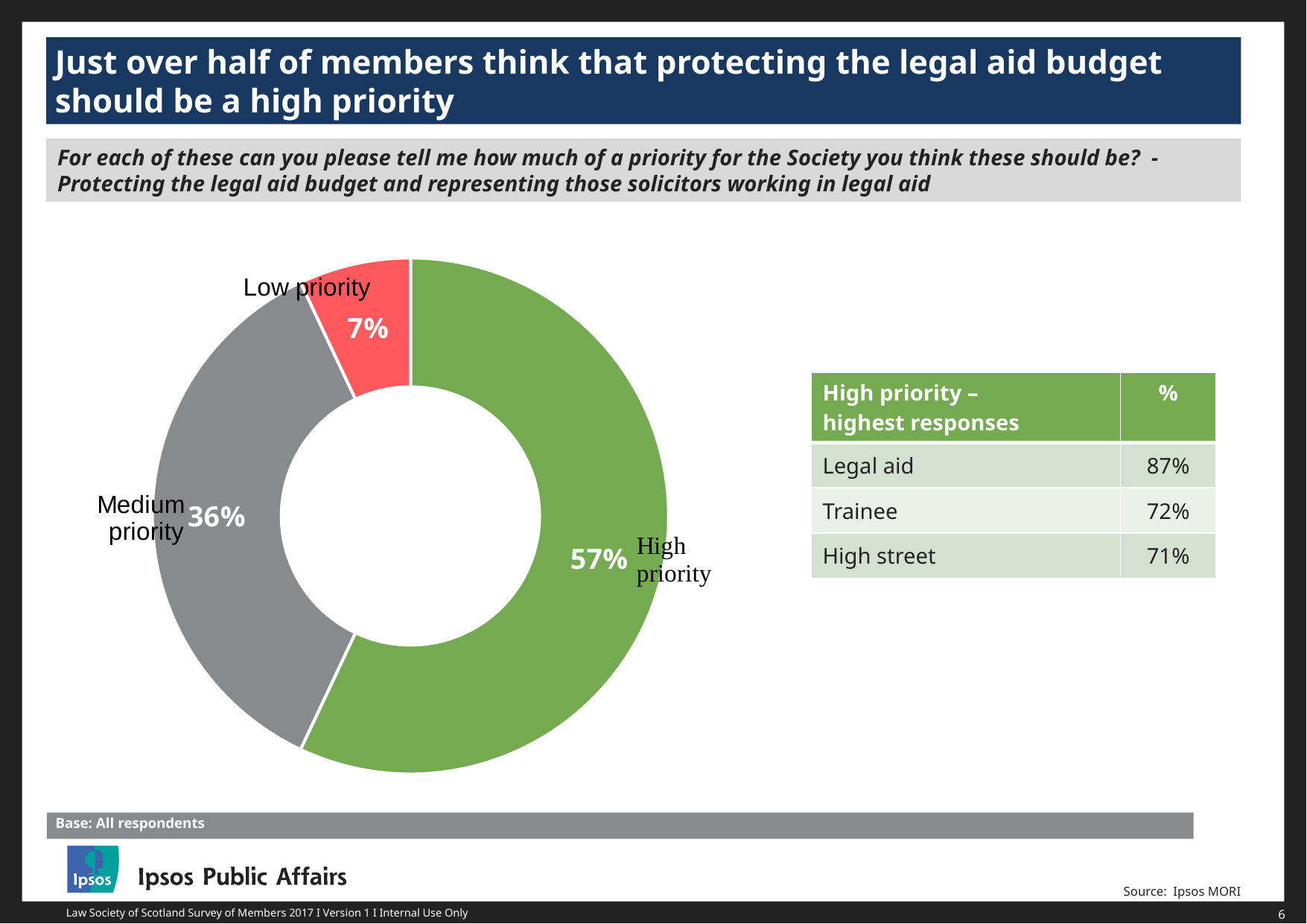
What percentage of members said protecting the legal aid budget should be a medium priority? 36% What is the difference in percentage points between the medium priority and low priority shares? 29 What percentage of members said protecting the legal aid budget should be a low priority? 7% What colour is the high priority segment of the chart? Green Which is larger, the share for medium priority or the share for low priority? Medium priority Which priority level has the largest share of the chart? High priority What percentage of members said protecting the legal aid budget should be a high priority? 57% What colour is the low priority segment of the chart? Red What is the difference in percentage points between the high priority and medium priority shares? 21 What kind of chart is shown on the slide? Doughnut chart How many categories are shown in the chart? 3 Which priority level has the smallest share of the chart? Low priority